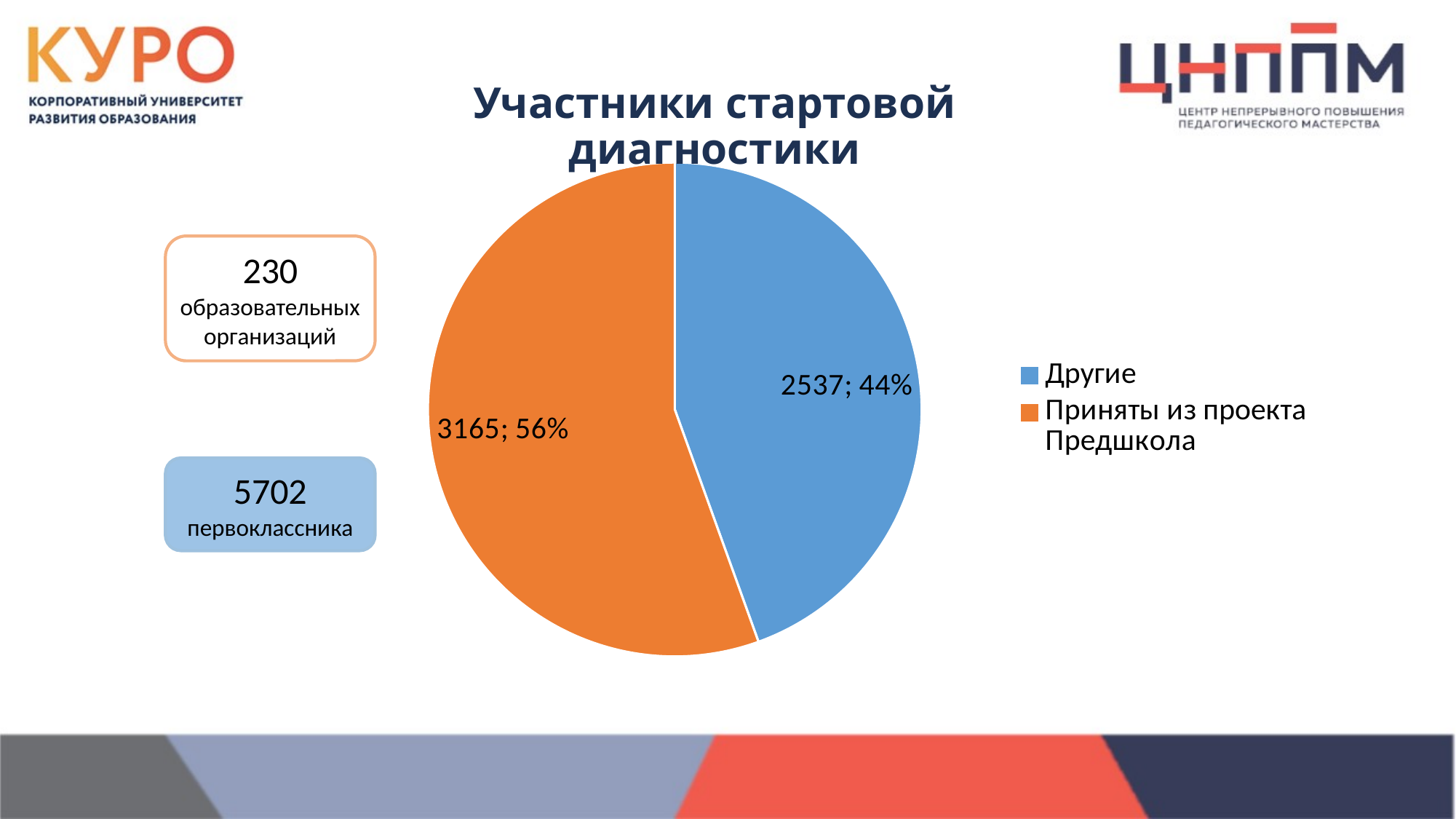
What kind of chart is shown on the slide? pie chart What is the value for Другие? 2537 What is the value for Приняты из проекта Предшкола? 3165 What share of the pie does Приняты из проекта Предшкола represent? 56% Which category has the largest slice? Приняты из проекта Предшкола What share of the pie does Другие represent? 44% Which colour represents Другие in the pie chart? blue How many entries does the legend list? 2 Which category has the smallest slice? Другие What is the title of the chart? Участники стартовой диагностики What is the difference between the values for Приняты из проекта Предшкола and Другие? 628 How many slices does the pie chart have? 2